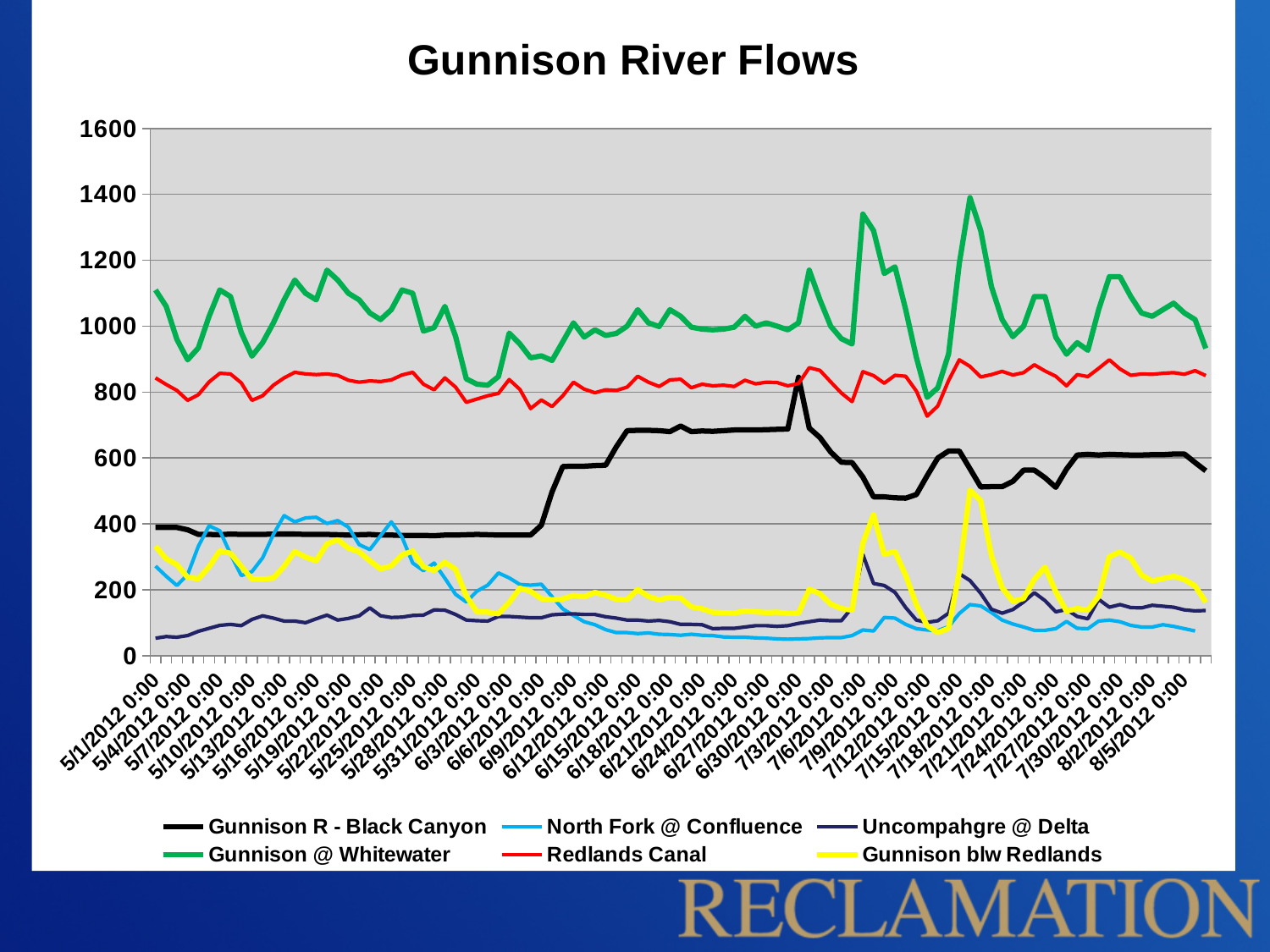
Which series has the highest values across the whole period? Gunnison @ Whitewater Which series is drawn in green? Gunnison @ Whitewater Is the value for Gunnison R - Black Canyon on 5/1/2012 0:00 greater or less than 600? less Is the value for Redlands Canal on 5/1/2012 0:00 greater or less than 1000? less On 7/3/2012 0:00, which is larger: Gunnison R - Black Canyon or Gunnison blw Redlands? Gunnison R - Black Canyon On 5/1/2012 0:00, which is larger: Gunnison @ Whitewater or Redlands Canal? Gunnison @ Whitewater Which series has the lowest value at 8/5/2012 0:00? North Fork @ Confluence What is the title of the chart? Gunnison River Flows What kind of chart is shown on the slide? line chart How many series does the legend list? 6 Is the value for North Fork @ Confluence on 7/3/2012 0:00 greater or less than 200? less